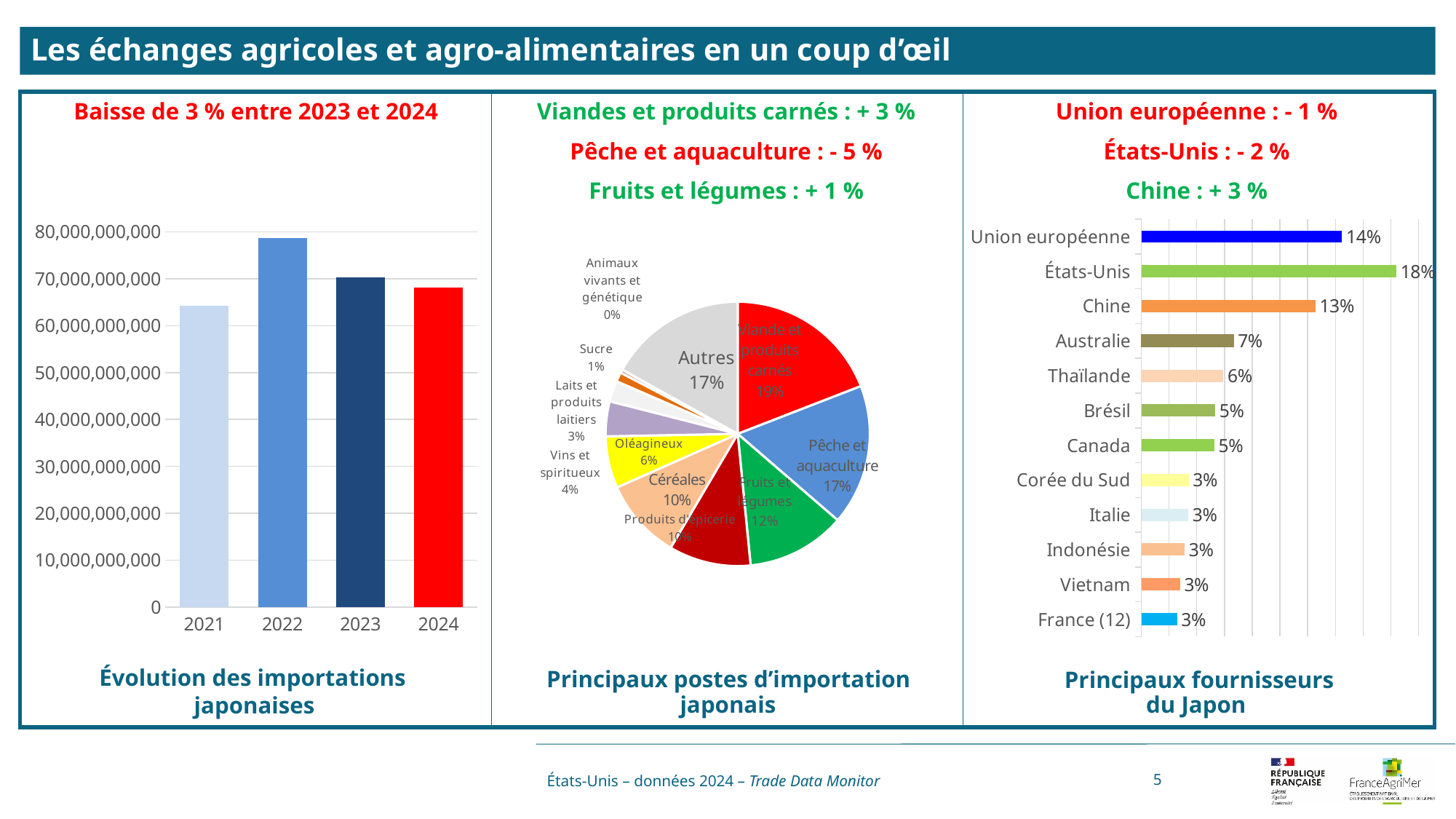
In the pie chart 'Principaux postes d'importation japonais', which category has the largest share? Viande et produits carnés In the chart 'Principaux fournisseurs du Japon', which is larger, the value for Australie or the value for Thaïlande? Australie In the chart 'Principaux fournisseurs du Japon', what is the difference between the values for États-Unis and Union européenne? 4 percentage points In the chart 'Principaux fournisseurs du Japon', which supplier has the highest share? États-Unis What kind of chart is 'Évolution des importations japonaises'? bar chart In the pie chart 'Principaux postes d'importation japonais', what is the share of 'Oléagineux'? 6% In the chart 'Principaux fournisseurs du Japon', what is the value for États-Unis? 18% In the chart 'Principaux fournisseurs du Japon', how many suppliers are listed? 12 In the pie chart 'Principaux postes d'importation japonais', what share does 'Viande et produits carnés' represent? 19% In the chart 'Évolution des importations japonaises', which year has the highest value? 2022 In the chart 'Principaux fournisseurs du Japon', what is the value for Chine? 13% In the chart 'Évolution des importations japonaises', is the value for 2021 greater or less than 70,000,000,000? less